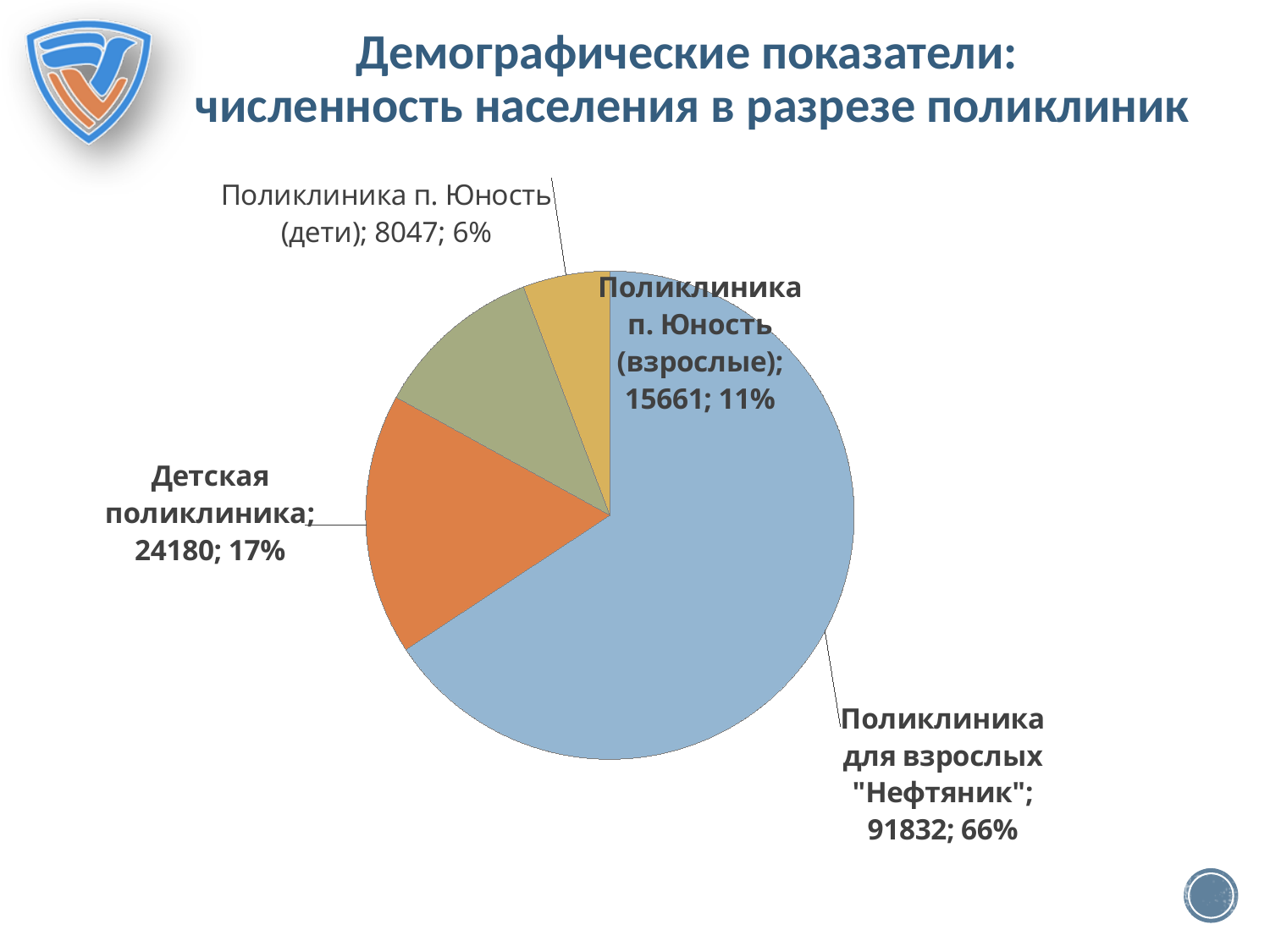
What share of the pie does Детская поликлиника represent? 17% What is the value for Поликлиника для взрослых "Нефтяник"? 91832 Which category has the largest slice of the pie? Поликлиника для взрослых "Нефтяник" What kind of chart is shown on the slide? Pie chart Which category has the smallest slice of the pie? Поликлиника п. Юность (дети) What share of the pie does Поликлиника п. Юность (взрослые) represent? 11% Which is larger: the value for Поликлиника п. Юность (взрослые) or Поликлиника п. Юность (дети)? Поликлиника п. Юность (взрослые) What is the value for Детская поликлиника? 24180 What is the difference between the values for Детская поликлиника and Поликлиника п. Юность (взрослые)? 8519 What is the value for Поликлиника п. Юность (дети)? 8047 What is the value for Поликлиника п. Юность (взрослые)? 15661 How many slices does the pie chart have? 4